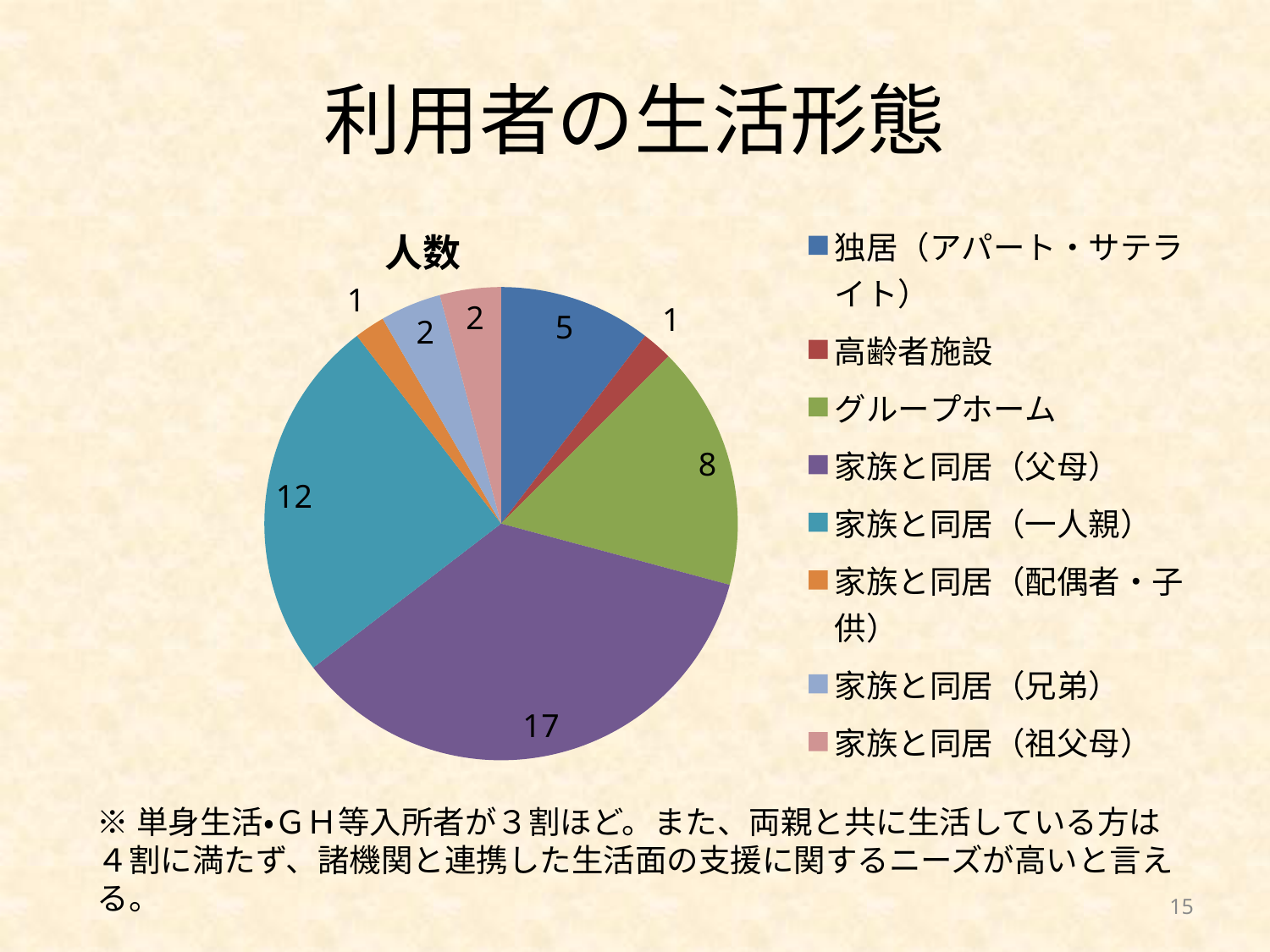
Which is larger, the value for グループホーム or the value for 独居（アパート・サテライト）? グループホーム What is the value for 家族と同居（一人親）? 12 What is the value for 家族と同居（父母）? 17 What is the difference between the values for 家族と同居（父母） and 家族と同居（一人親）? 5 What type of chart is shown on the slide? pie chart What is the value for 独居（アパート・サテライト）? 5 How many categories does the legend list? 8 What is the value for グループホーム? 8 Which category has the largest slice? 家族と同居（父母） What is the title of the chart? 人数 What share of the pie does 家族と同居（一人親） represent? 25% What is the total of all the values in the pie chart? 48